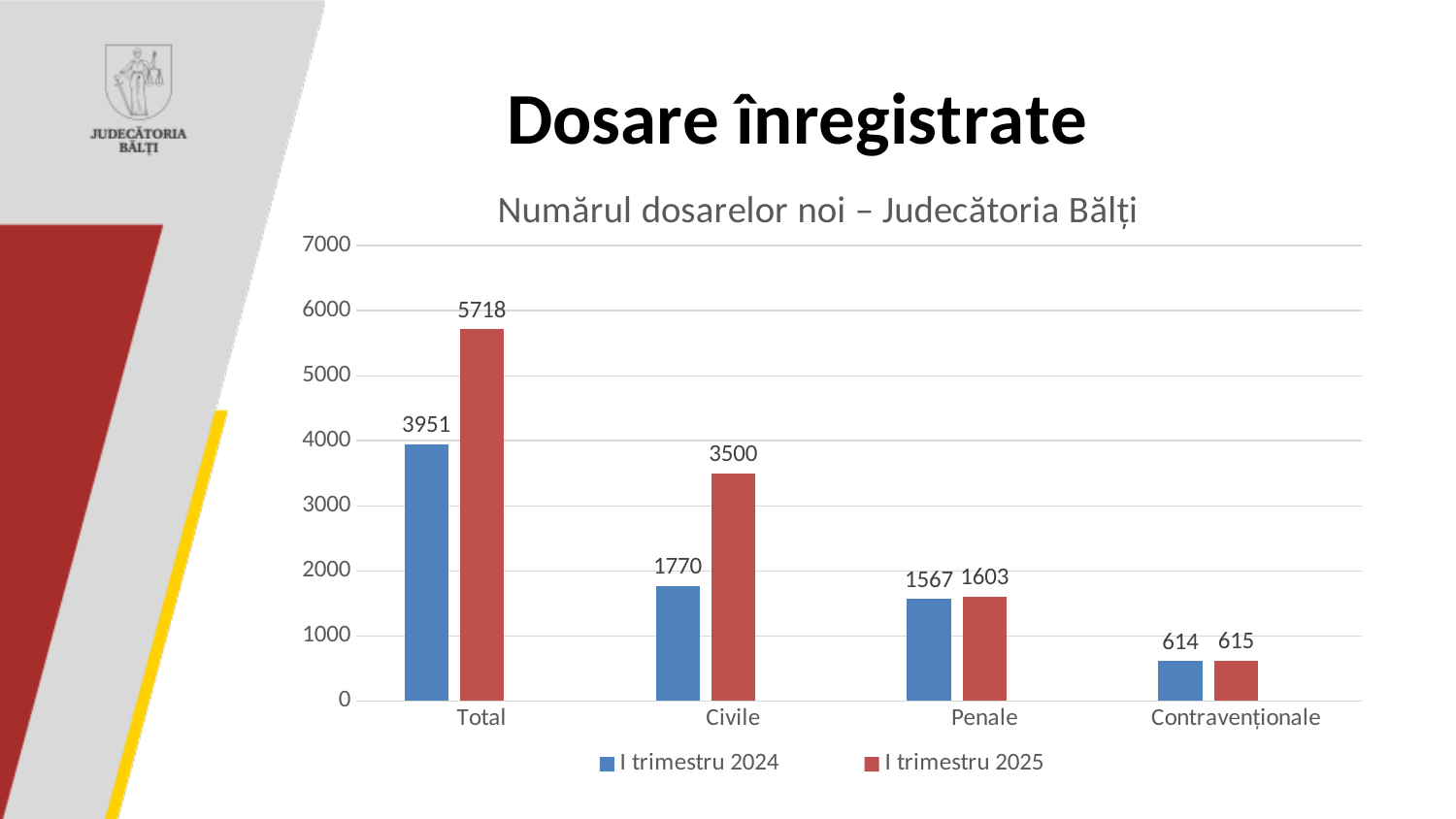
What is the value for Penale in I trimestru 2025? 1603 Which category has the highest value in I trimestru 2024? Total What is the value for Civile in I trimestru 2024? 1770 What is the value for Contravenționale in I trimestru 2024? 614 What is the difference between the Total values for I trimestru 2025 and I trimestru 2024? 1767 How many categories are shown on the x axis? 4 Which category has the lowest value in I trimestru 2025? Contravenționale What is the difference between the Civile values for I trimestru 2025 and I trimestru 2024? 1730 How many series does the legend list? 2 What kind of chart is shown on the slide? Bar chart Which is larger for Civile: I trimestru 2024 or I trimestru 2025? I trimestru 2025 What is the value for Total in I trimestru 2025? 5718